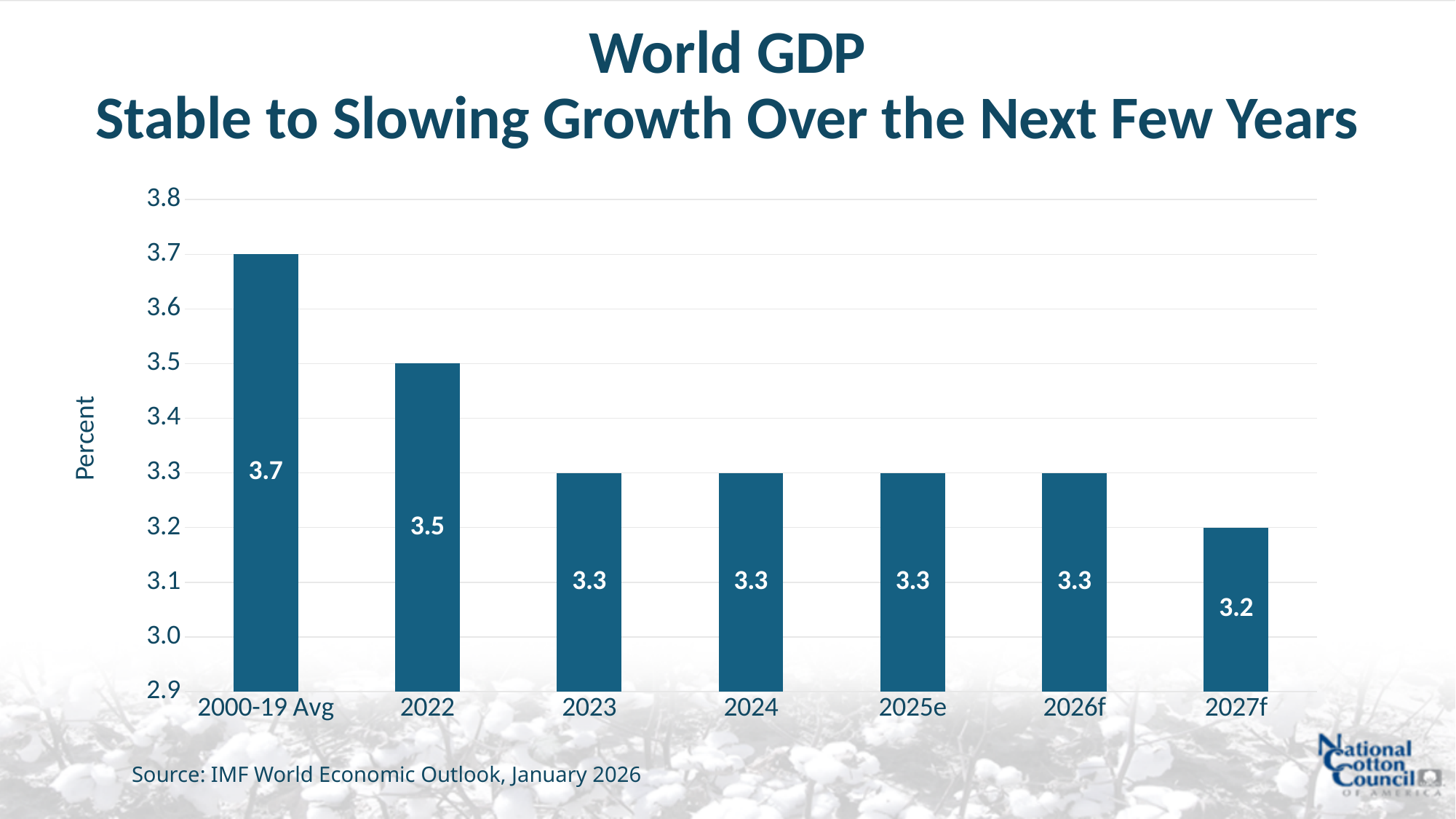
What is the World GDP growth value for 2022? 3.5 How many categories are shown on the x axis? 7 Which is larger, the value for 2022 or the value for 2023? 2022 What is the difference between the 2000-19 Avg value and the 2027f value? 0.5 Which category has the highest World GDP growth value? 2000-19 Avg What kind of chart is shown on the slide? Bar chart What is the World GDP growth value for 2000-19 Avg? 3.7 Which category has the lowest World GDP growth value? 2027f What is the label of the y axis? Percent What is the World GDP growth value for 2027f? 3.2 What is the World GDP growth value for 2025e? 3.3 Is the value for 2022 greater or less than 3.4? greater